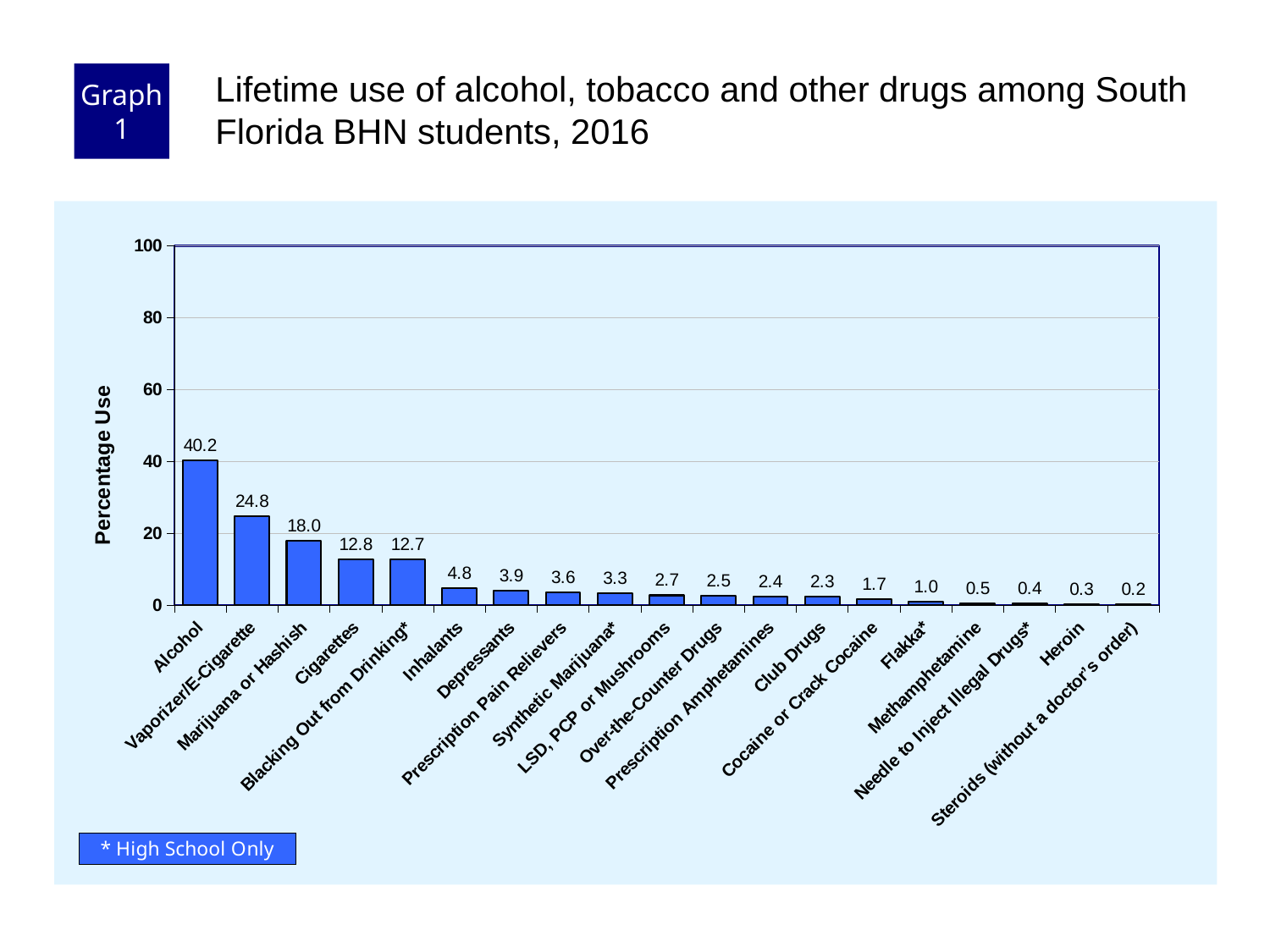
Which category has the highest percentage use? Alcohol What is the percentage use value for Vaporizer/E-Cigarette? 24.8 What is the label of the y axis? Percentage Use What is the difference between the values for Alcohol and Vaporizer/E-Cigarette? 15.4 What is the percentage use value for Alcohol? 40.2 How many categories are shown on the x axis? 19 Which has a higher percentage use, Marijuana or Hashish or Cigarettes? Marijuana or Hashish Is the value for Alcohol greater or less than 20? greater Which category has the lowest percentage use? Steroids (without a doctor's order) What kind of chart is shown on the slide? Bar chart What is the percentage use value for Inhalants? 4.8 What is the percentage use value for Heroin? 0.3